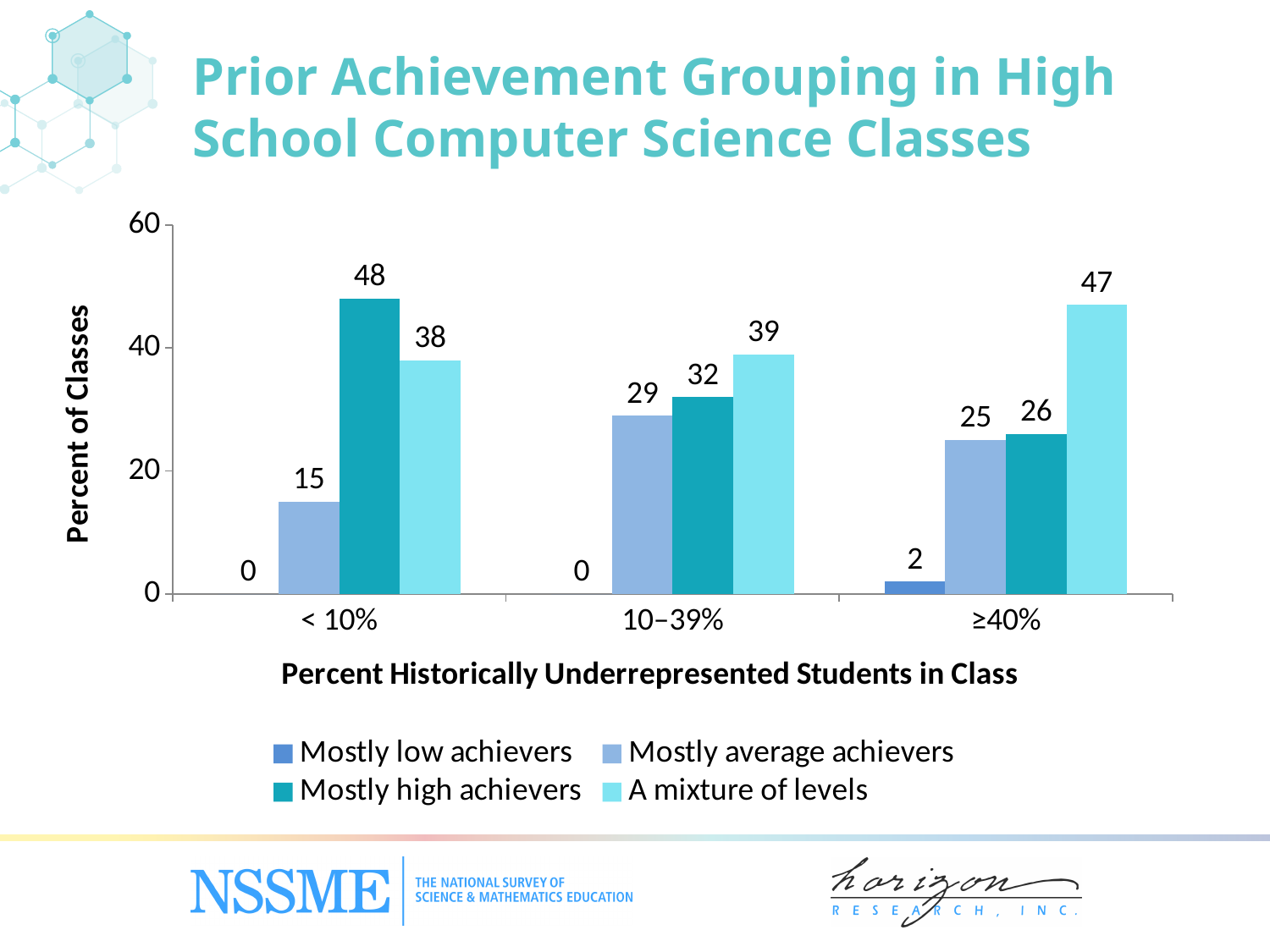
How many series does the legend list? 4 What is the difference between "Mostly high achievers" and "A mixture of levels" in the "< 10%" category? 10 How many categories are shown on the x axis? 3 What is the value for "Mostly high achievers" in the "< 10%" category? 48 Which is larger: "Mostly high achievers" in "< 10%" or "Mostly high achievers" in "≥40%"? Mostly high achievers in < 10% Which series has the highest value in the "10–39%" category? A mixture of levels What kind of chart is shown on the slide? Bar chart Do the values for "Mostly high achievers" rise or fall across the categories from left to right? Fall What is the value for "Mostly low achievers" in the "≥40%" category? 2 What is the value for "Mostly average achievers" in the "10–39%" category? 29 Which series has the lowest value in the "< 10%" category? Mostly low achievers What is the value for "A mixture of levels" in the "≥40%" category? 47